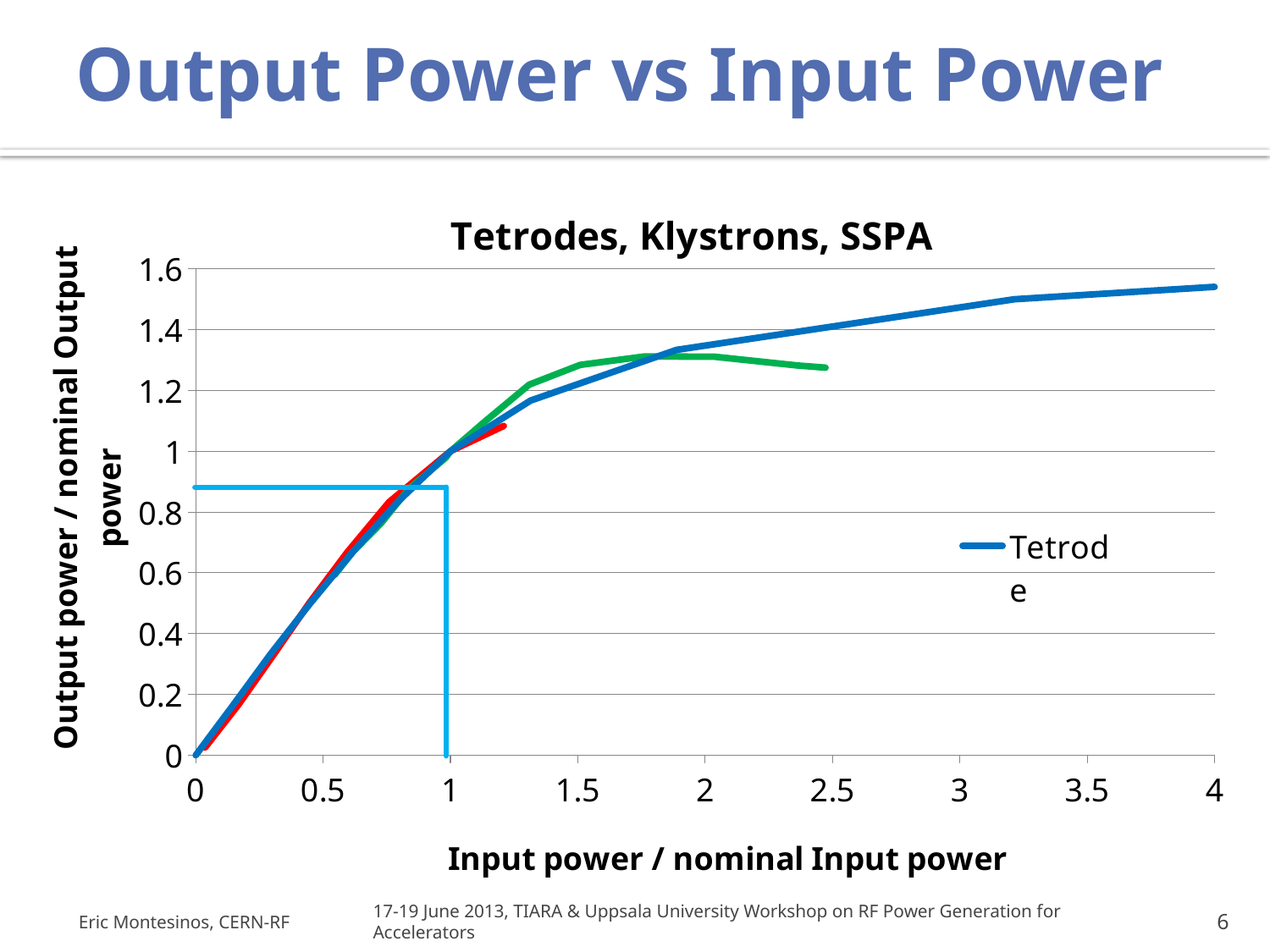
What kind of chart is shown on the slide? line chart Does the Tetrode line rise or fall as the input power ratio increases from 0 to 4? rise Is the value of the Tetrode line at an input power ratio of 4 greater or less than 1.4? greater What is the title of the chart? Tetrodes, Klystrons, SSPA Is the value of the Tetrode line at an input power ratio of 3 greater or less than 1.4? greater How many series does the chart legend list? 1 What is the highest value shown on the x axis? 4 What is the label of the series listed in the legend? Tetrode Is the value of the Tetrode line at an input power ratio of 2 greater or less than 1.2? greater